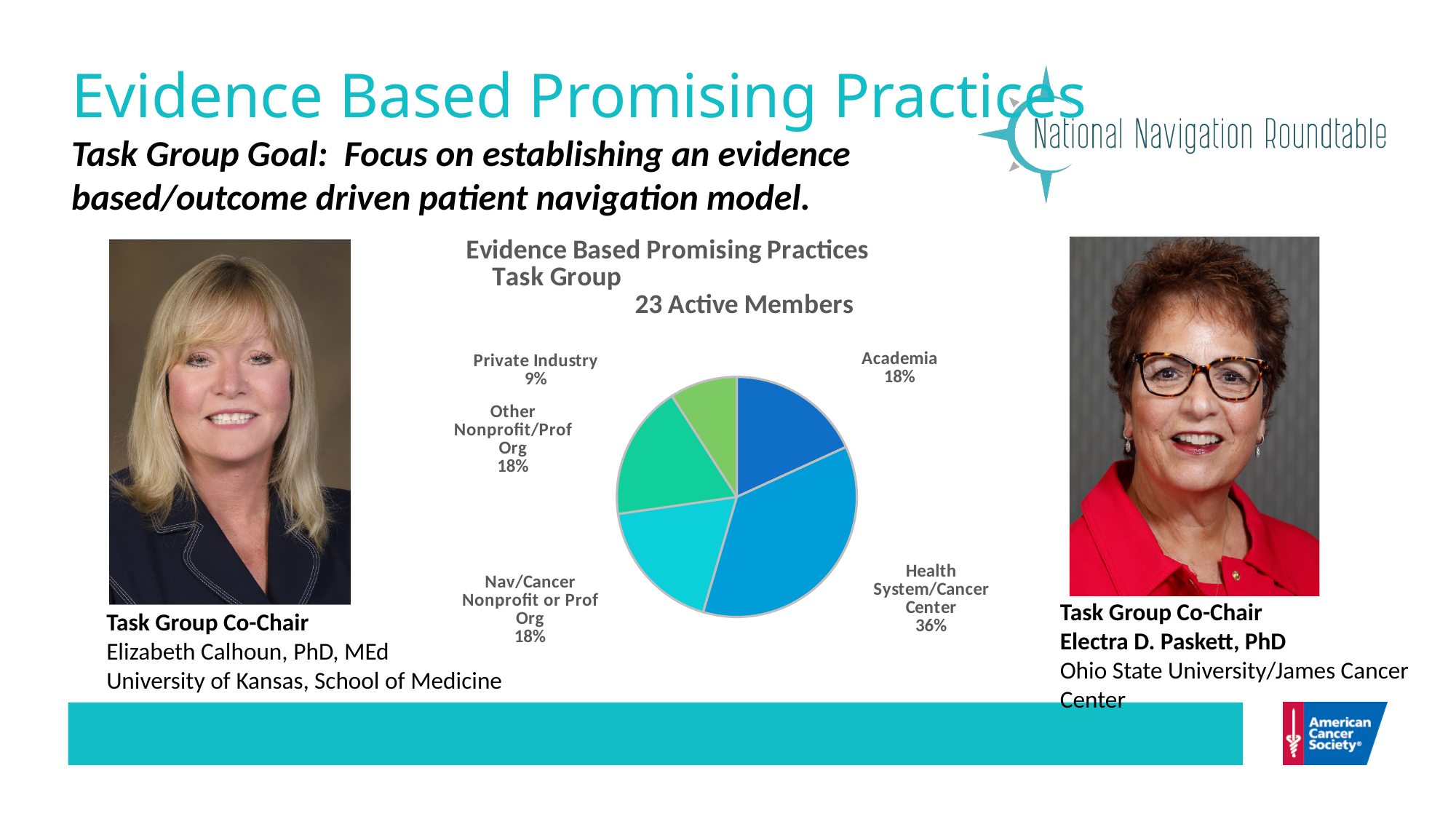
What is the difference in percentage points between Health System/Cancer Center and Private Industry? 27 How many active members does the chart title say the task group has? 23 Which category has the largest slice of the pie? Health System/Cancer Center What share of the pie does Nav/Cancer Nonprofit or Prof Org represent? 18% What is the title of the pie chart? Evidence Based Promising Practices Task Group 23 Active Members What share of the pie does Academia represent? 18% What share of the pie does Private Industry represent? 9% Which is larger, the share for Academia or the share for Private Industry? Academia How many categories are shown in the pie chart? 5 What kind of chart is shown on the slide? pie chart Which category has the smallest slice of the pie? Private Industry